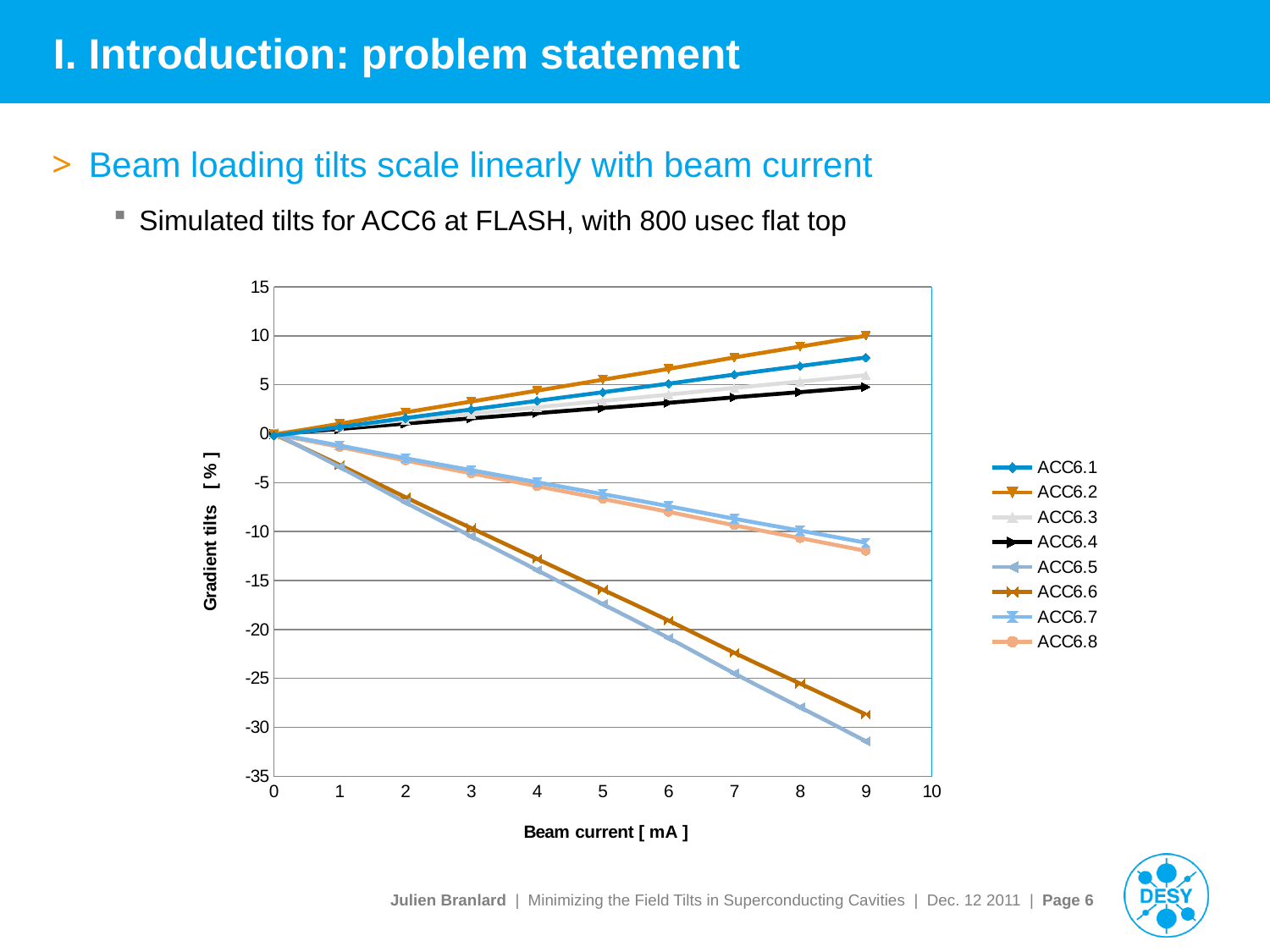
Which series has the lowest gradient tilt at 9 mA? ACC6.5 What kind of chart is shown on the slide? line chart At 9 mA, which is larger: the value for ACC6.1 or the value for ACC6.4? ACC6.1 Do the values for ACC6.5 rise or fall as beam current increases? fall How many data points are plotted for each series along the beam current axis? 10 How many series does the legend list? 8 Which series has the highest gradient tilt at 9 mA? ACC6.2 What is the label of the x axis? Beam current [ mA ] Is the value for ACC6.6 at 5 mA greater or less than -15? less Is the value for ACC6.5 at 9 mA greater or less than -30? less Do the values for ACC6.1 rise or fall as beam current increases? rise